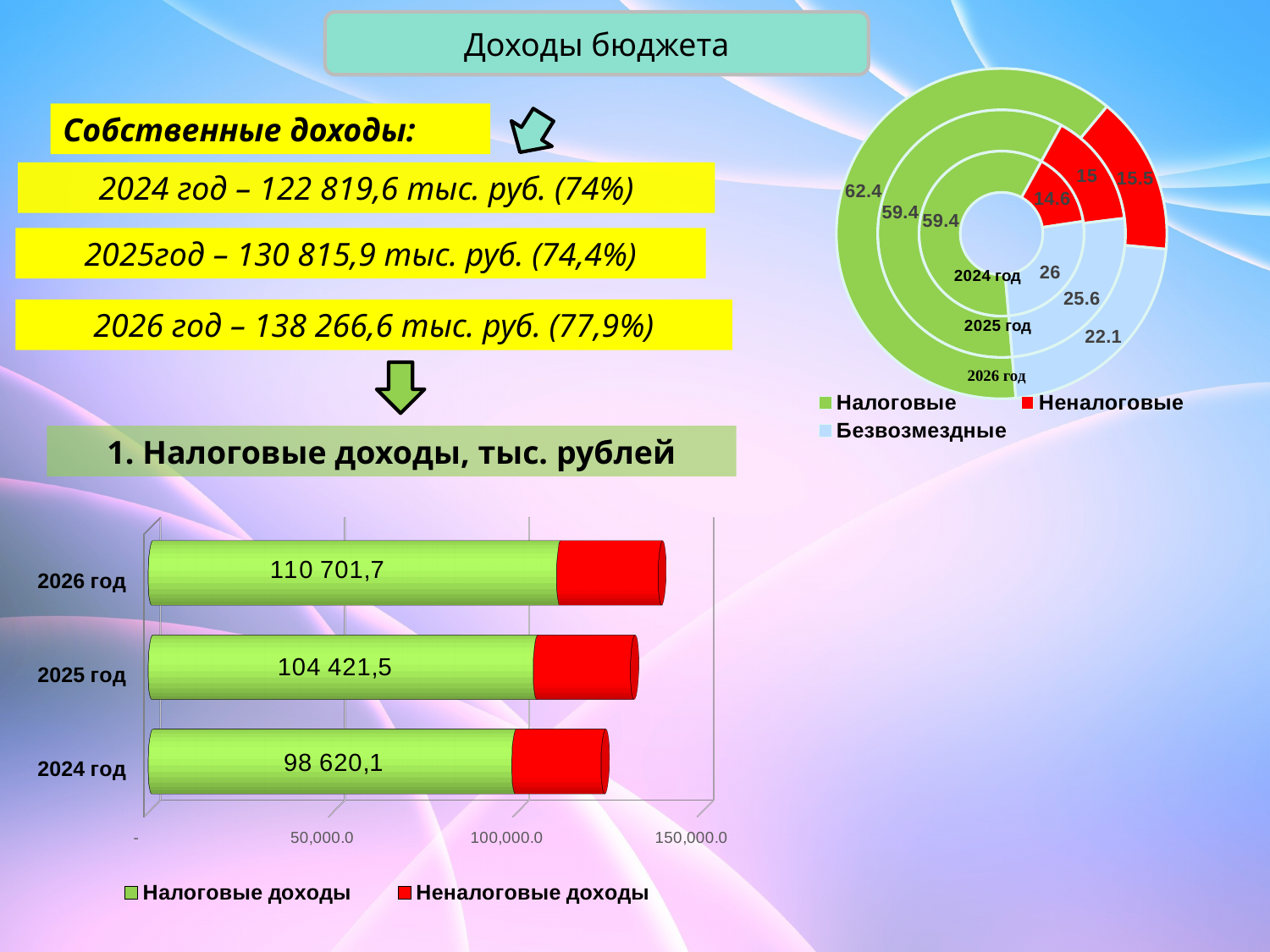
In the doughnut chart at the top right, what is the value of Налоговые for 2026 год? 62.4 In the bar chart titled "1. Налоговые доходы, тыс. рублей", what is the value of Налоговые доходы for 2024 год? 98 620,1 In the bar chart titled "1. Налоговые доходы, тыс. рублей", is the Налоговые доходы value for 2024 год greater or less than 100,000.0? less In the doughnut chart at the top right, what is the value of Неналоговые for 2024 год? 14.6 In the bar chart titled "1. Налоговые доходы, тыс. рублей", which year has the highest Налоговые доходы? 2026 год How many series does the legend of the doughnut chart at the top right list? 3 What kind of chart is the one titled "1. Налоговые доходы, тыс. рублей"? bar chart In the doughnut chart at the top right, what is the value of Безвозмездные for 2025 год? 25.6 In the bar chart titled "1. Налоговые доходы, тыс. рублей", what is the difference between Налоговые доходы for 2026 год and 2024 год? 12 081,6 In the bar chart titled "1. Налоговые доходы, тыс. рублей", what is the value of Налоговые доходы for 2026 год? 110 701,7 How many series does the legend of the bar chart titled "1. Налоговые доходы, тыс. рублей" list? 2 How many years are shown in the bar chart titled "1. Налоговые доходы, тыс. рублей"? 3